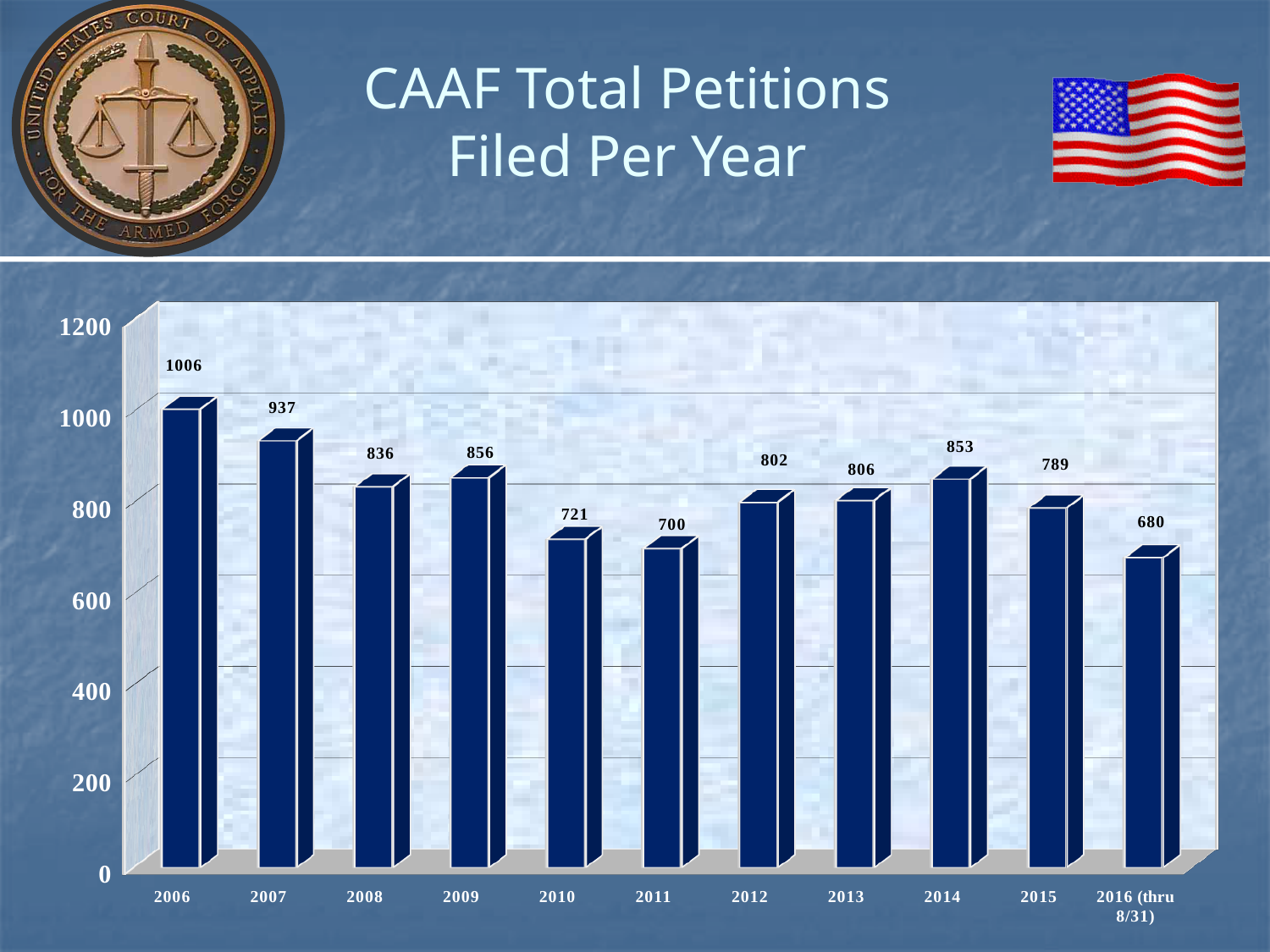
What is the difference between the values for 2014 and 2015? 64 Which is larger, the value for 2008 or the value for 2009? 2009 Which year has the highest number of petitions filed? 2006 Is the value for 2011 greater or less than 800? less What is the value shown for 2010? 721 How many categories are shown on the x axis? 11 Which category has the lowest value? 2016 (thru 8/31) What is the value shown for 2016 (thru 8/31)? 680 What is the difference between the values for 2006 and 2007? 69 How many petitions were filed in 2006? 1006 What is the title of the slide? CAAF Total Petitions Filed Per Year What kind of chart is shown on the slide? bar chart